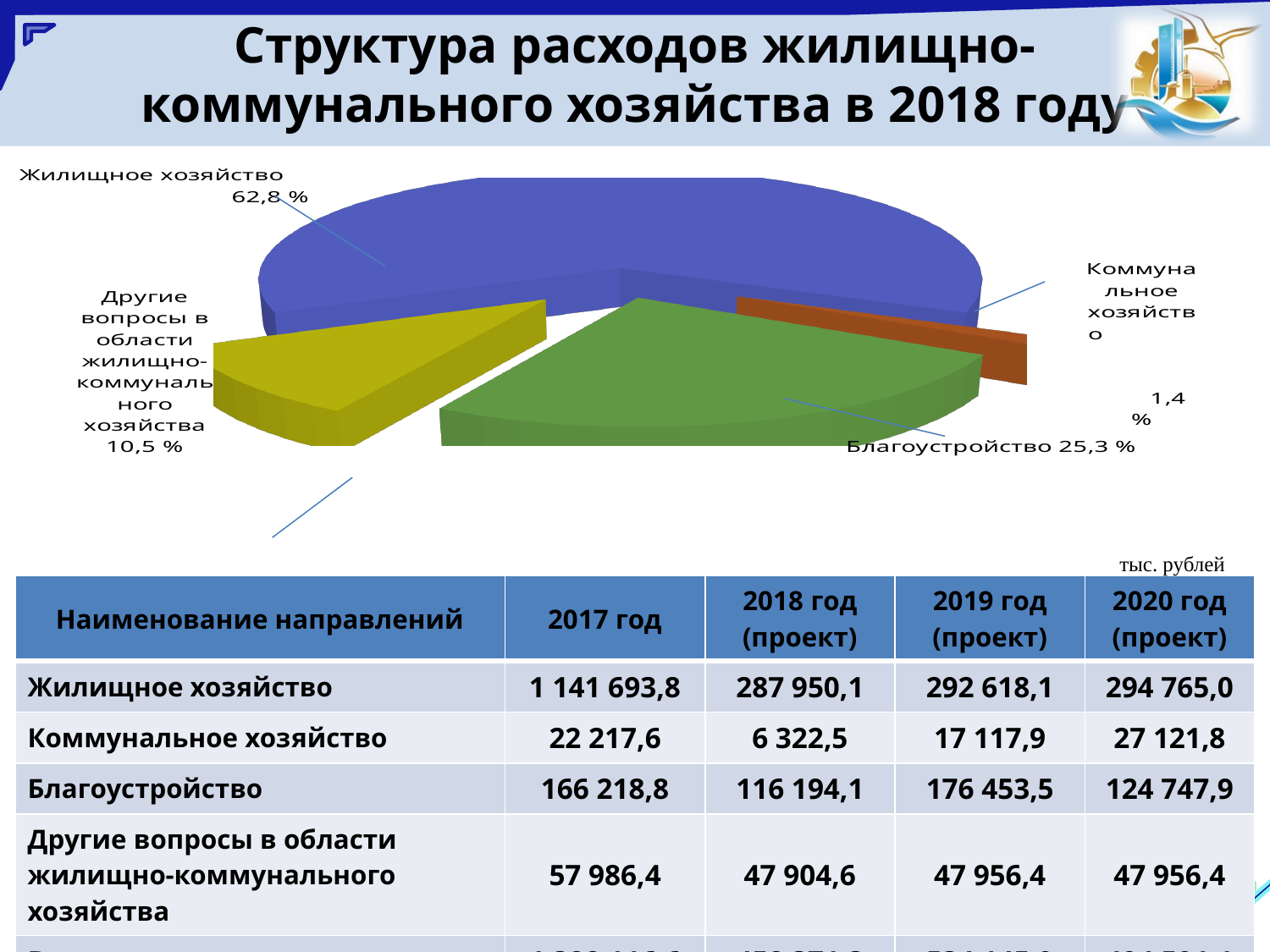
Which slice of the pie chart is the largest? Жилищное хозяйство What is the title of the slide containing the pie chart? Структура расходов жилищно-коммунального хозяйства в 2018 году What share of the pie does Благоустройство have? 25,3 % Which is larger in the pie chart: Благоустройство or Другие вопросы в области жилищно-коммунального хозяйства? Благоустройство What kind of chart is shown on the slide? Pie chart What is the difference in percentage points between the Жилищное хозяйство slice and the Благоустройство slice? 37,5 What share of the pie does Другие вопросы в области жилищно-коммунального хозяйства have? 10,5 % What colour is the Благоустройство slice in the pie chart? Green Which slice of the pie chart is the smallest? Коммунальное хозяйство What share of the pie does Коммунальное хозяйство have? 1,4 % How many slices does the pie chart have? 4